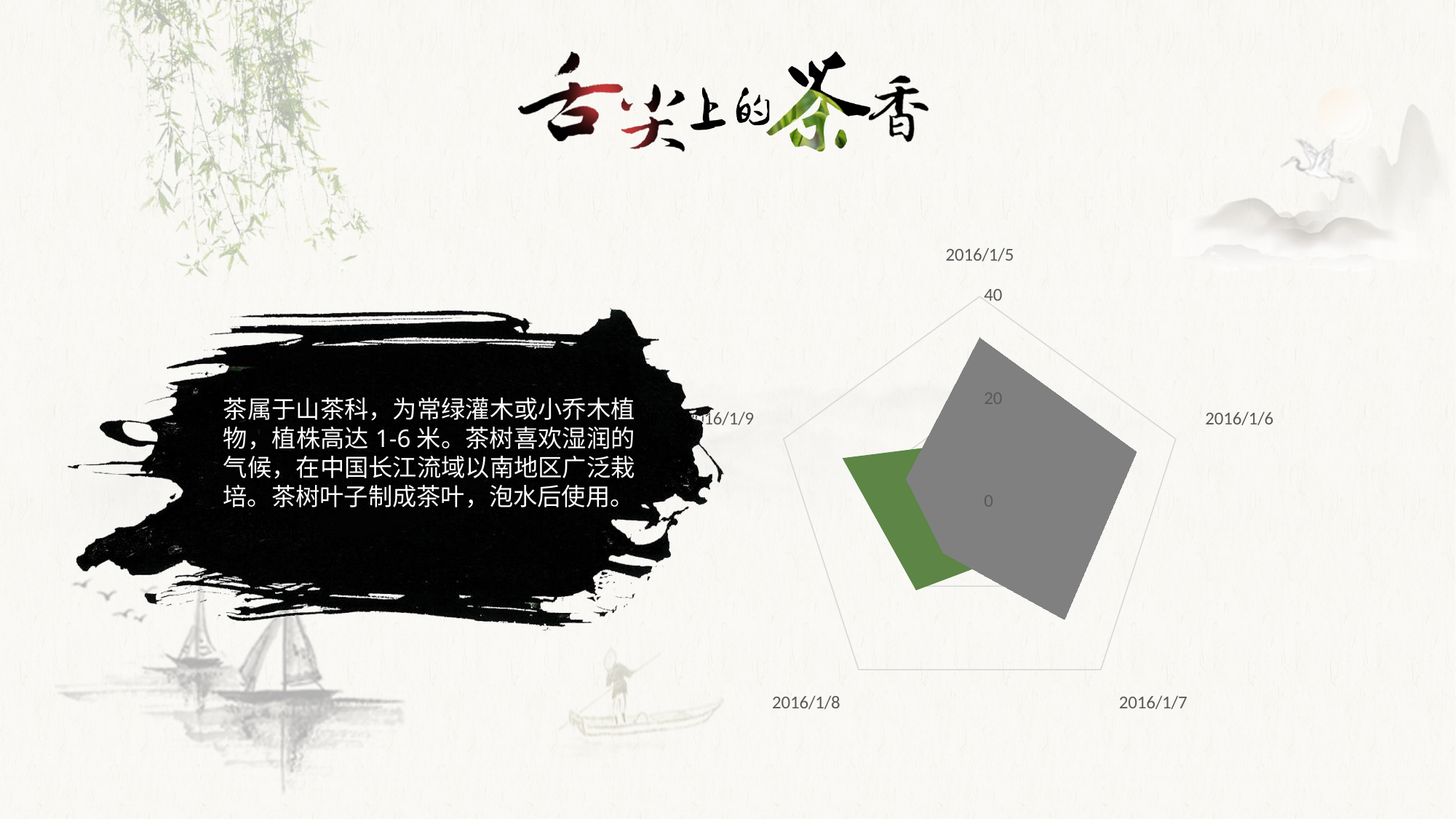
What is the highest value shown on the radar chart's axis scale? 40 How many data series are plotted on the radar chart? 2 At 2016/1/9, which series has the larger value, the gray one or the green one? green How many categories (axes) does the radar chart have? 5 Is the green series value for 2016/1/9 greater or less than 20? greater Is the gray series value for 2016/1/5 greater or less than 20? greater What kind of chart is shown on the slide? radar chart At 2016/1/6, which series has the larger value, the gray one or the green one? gray Which category label appears at the top of the radar chart? 2016/1/5 Is the gray series value for 2016/1/6 greater or less than 20? greater For the green series, which category has the highest value? 2016/1/9